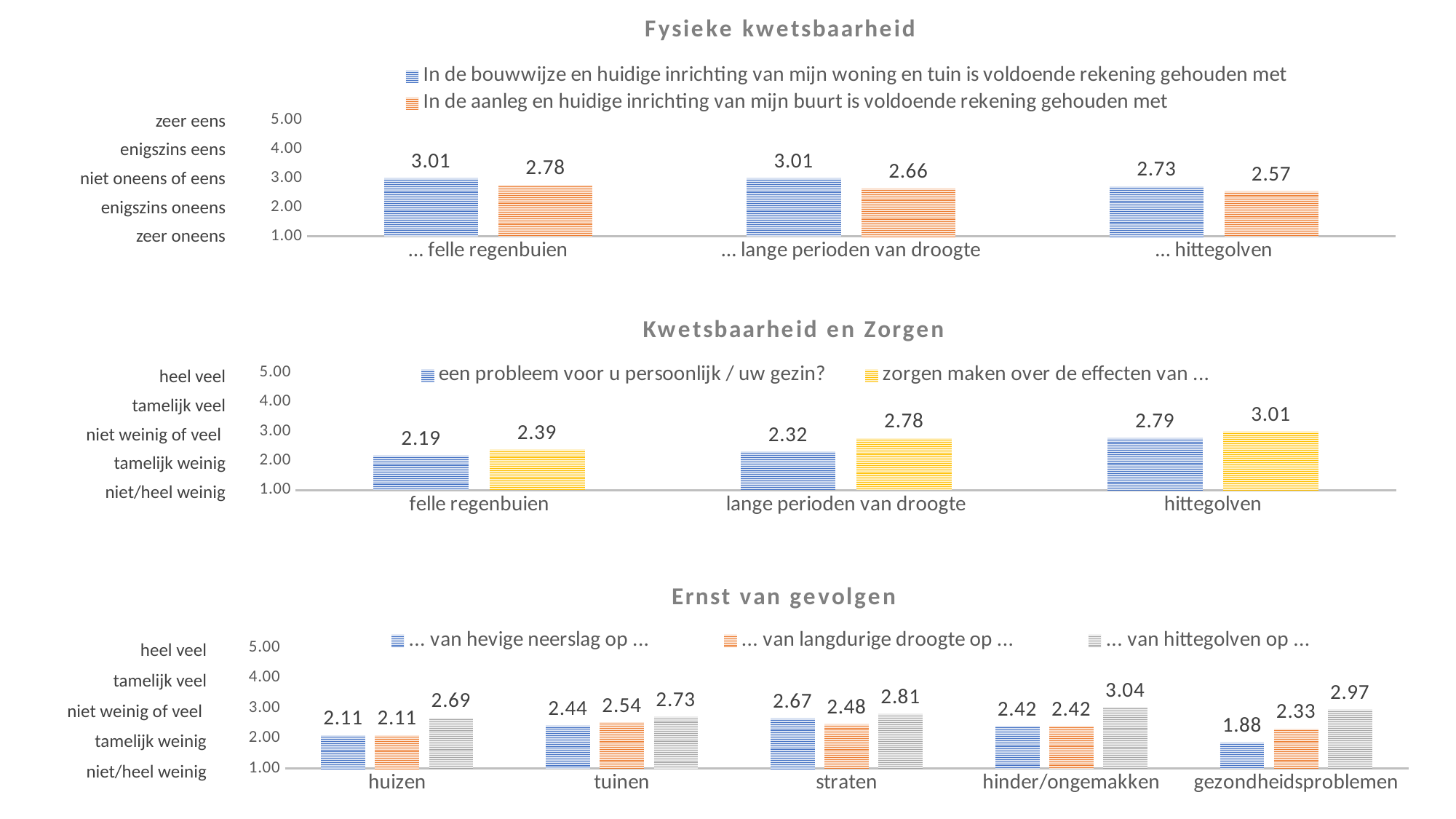
What kind of chart is 'Ernst van gevolgen'? bar chart In the 'Kwetsbaarheid en Zorgen' chart, what is the value of 'zorgen maken over de effecten van ...' for 'lange perioden van droogte'? 2.78 In the 'Kwetsbaarheid en Zorgen' chart, which category has the highest value for 'een probleem voor u persoonlijk / uw gezin?'? hittegolven In the 'Ernst van gevolgen' chart, which category has the lowest value for '... van hevige neerslag op ...'? gezondheidsproblemen In the 'Ernst van gevolgen' chart, what is the value of '... van hittegolven op ...' for 'hinder/ongemakken'? 3.04 In the 'Ernst van gevolgen' chart, how many categories are shown on the x axis? 5 In the 'Ernst van gevolgen' chart, which is larger for 'straten': '... van hevige neerslag op ...' or '... van langdurige droogte op ...'? ... van hevige neerslag op ... In the 'Fysieke kwetsbaarheid' chart, what is the value of the blue series ('In de bouwwijze en huidige inrichting van mijn woning en tuin...') for '... felle regenbuien'? 3.01 In the 'Kwetsbaarheid en Zorgen' chart, do the values of the yellow series rise or fall from 'felle regenbuien' to 'hittegolven'? rise In the 'Fysieke kwetsbaarheid' chart, what is the difference between the blue and orange values for '... lange perioden van droogte'? 0.35 In the 'Fysieke kwetsbaarheid' chart, how many series does the legend list? 2 In the 'Fysieke kwetsbaarheid' chart, what is the value of the orange series for '... hittegolven'? 2.57